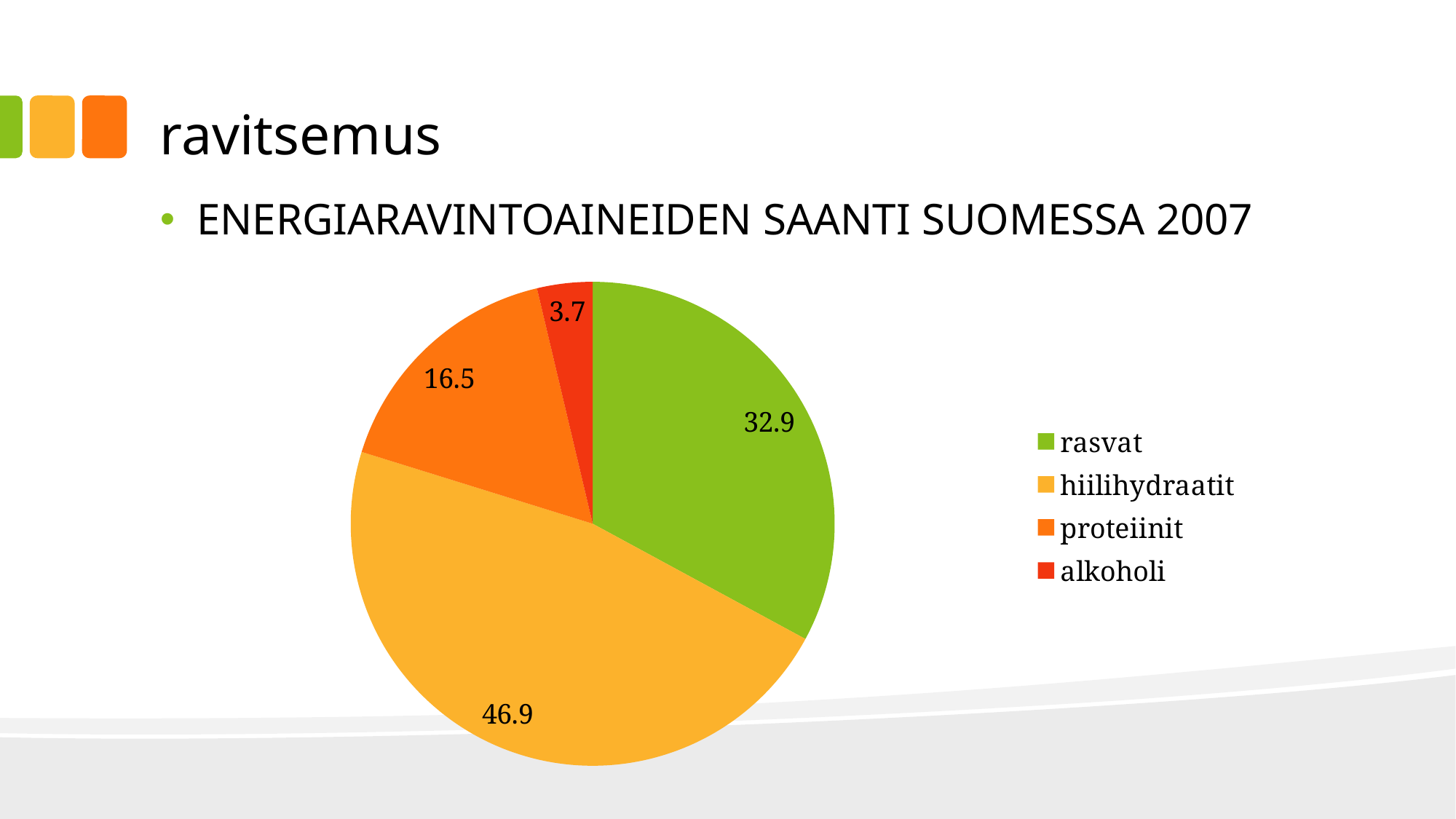
What is the value for rasvat? 32.9 What is the value for proteiinit? 16.5 What colour is the slice for alkoholi? red What is the value for hiilihydraatit? 46.9 What kind of chart is shown on the slide? pie chart Which is larger, the value for rasvat or the value for proteiinit? rasvat What is the value for alkoholi? 3.7 What is the difference between the values for proteiinit and alkoholi? 12.8 How many categories does the pie chart have? 4 Which category has the largest slice? hiilihydraatit Which category has the smallest slice? alkoholi What is the difference between the values for hiilihydraatit and rasvat? 14.0